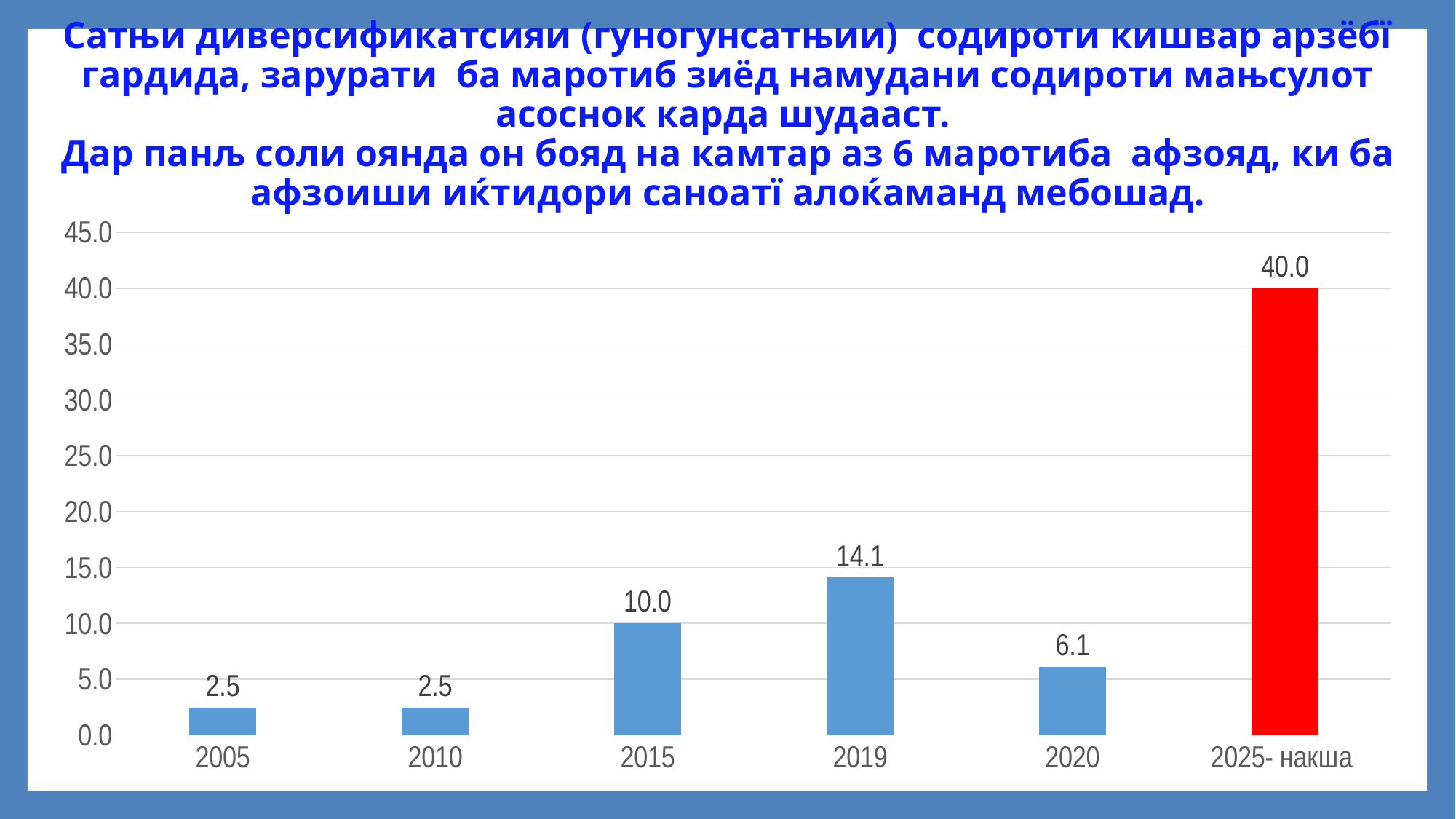
What is the value for 2015? 10.0 How many bars are shown in the chart? 6 What is the value for 2025- накша? 40.0 What is the value for 2020? 6.1 What is the difference between the values for 2025- накша and 2019? 25.9 Which bar is coloured red? 2025- накша What is the difference between the values for 2019 and 2020? 8.0 Which category has the highest value? 2025- накша Which is larger, the value for 2015 or the value for 2020? 2015 Which category has the highest value among the blue bars? 2019 What kind of chart is shown on the slide? bar chart What is the value for 2019? 14.1